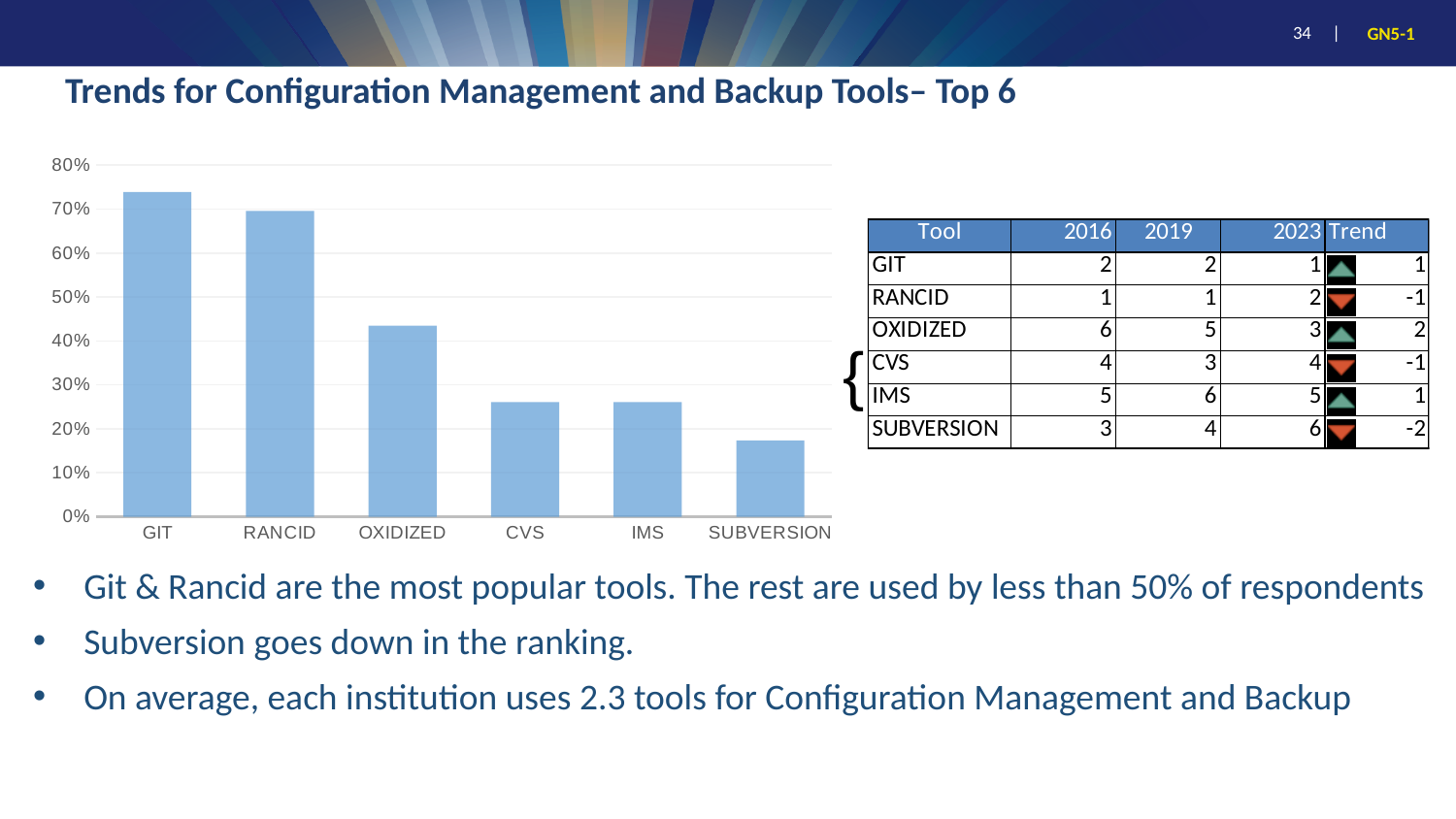
Is the value for GIT greater or less than 70%? greater Which has the larger value, OXIDIZED or CVS? OXIDIZED Is the value for SUBVERSION greater or less than 20%? less Is the value for CVS greater or less than 30%? less How many tools are shown on the x axis of the bar chart? 6 What is the title of the slide containing the chart? Trends for Configuration Management and Backup Tools– Top 6 What kind of chart is shown on the slide? bar chart Which tool has the lowest bar in the chart? SUBVERSION Which tool has the highest bar in the chart? GIT Do the bar values generally rise or fall from left to right along the x axis? fall